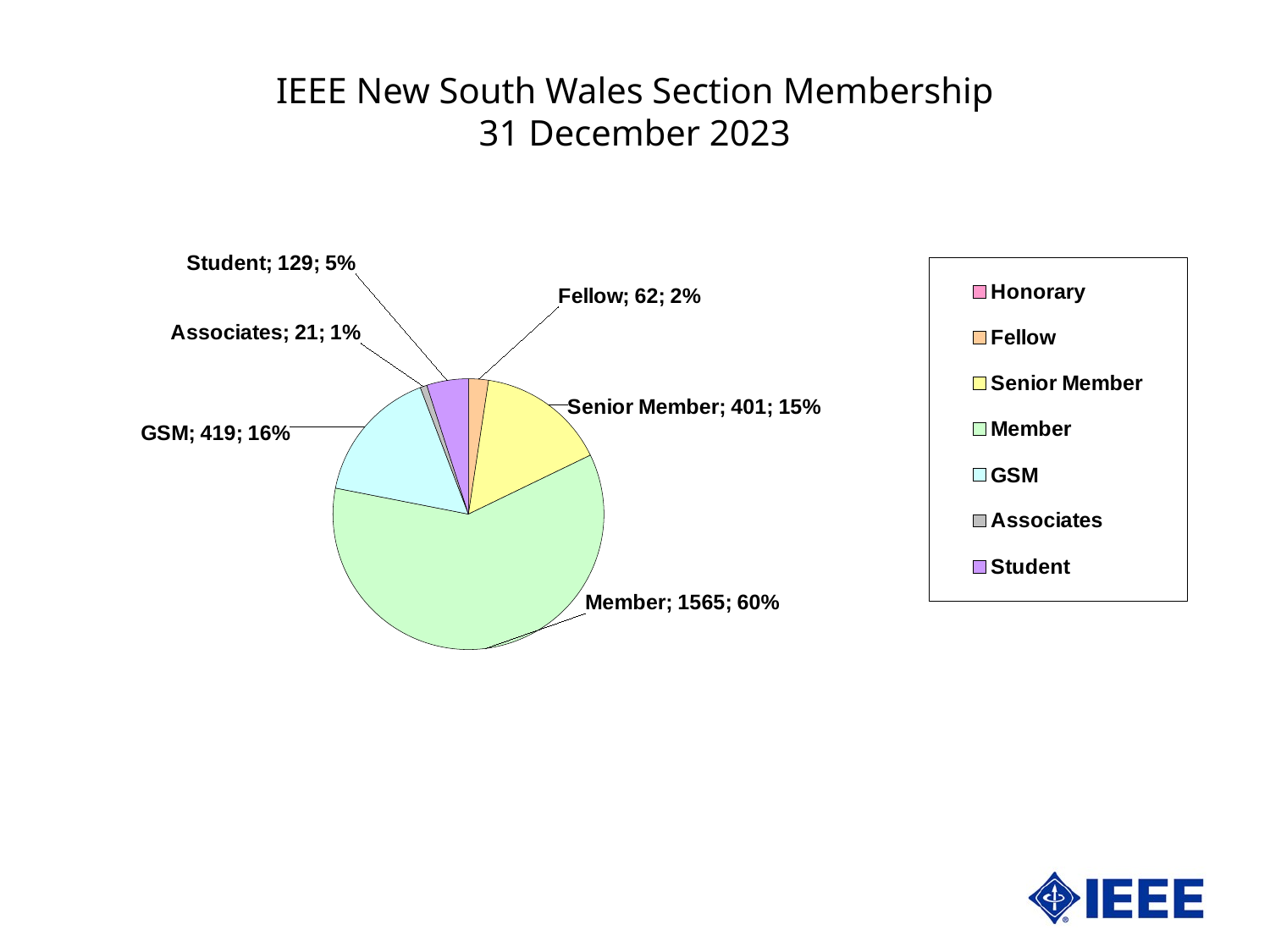
What is the difference between the GSM value and the Senior Member value? 18 What percentage share does the GSM slice represent? 16% Which is larger, the Student value or the Fellow value? Student What percentage share does the Fellow slice represent? 2% Which category has the largest slice of the pie? Member How many members are in the Member category? 1565 What is the value shown for Associates? 21 What kind of chart is shown on the slide? pie chart How many entries does the legend list? 7 What is the title of the chart? IEEE New South Wales Section Membership 31 December 2023 Which labelled category has the smallest slice of the pie? Associates What is the value shown for Senior Member? 401